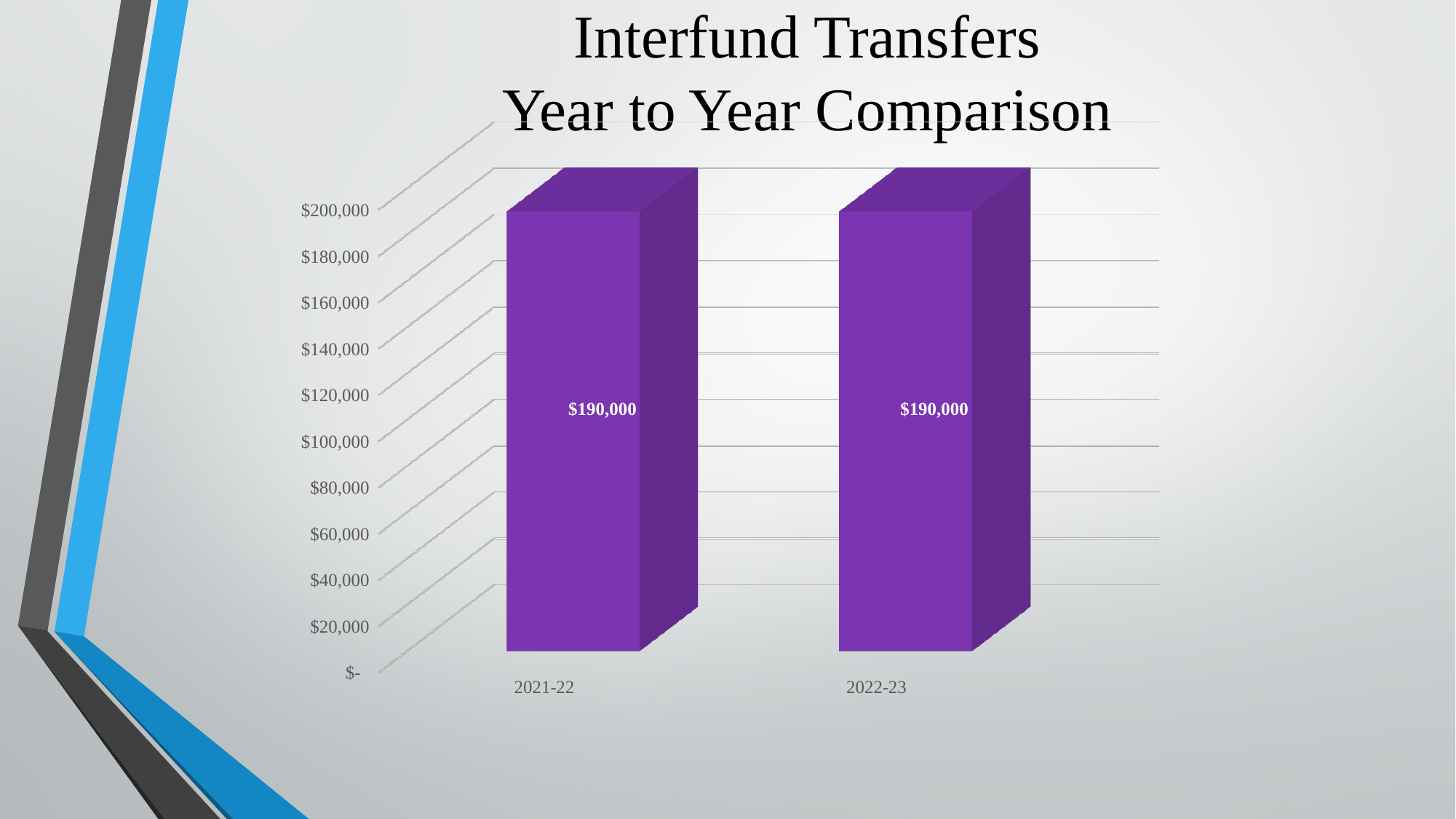
Is the value for 2021-22 greater or less than $100,000? greater What is the highest value shown on the vertical axis? $200,000 Do the values rise, fall, or stay the same from 2021-22 to 2022-23? stay the same How many categories are shown on the x axis? 2 What colour are the bars in the chart? purple What is the difference between the values for 2021-22 and 2022-23? $0 What kind of chart is shown on the slide? bar chart What is the title of the chart? Interfund Transfers Year to Year Comparison What is the value for 2022-23? $190,000 Is the value for 2022-23 greater or less than $200,000? less What is the value for 2021-22? $190,000